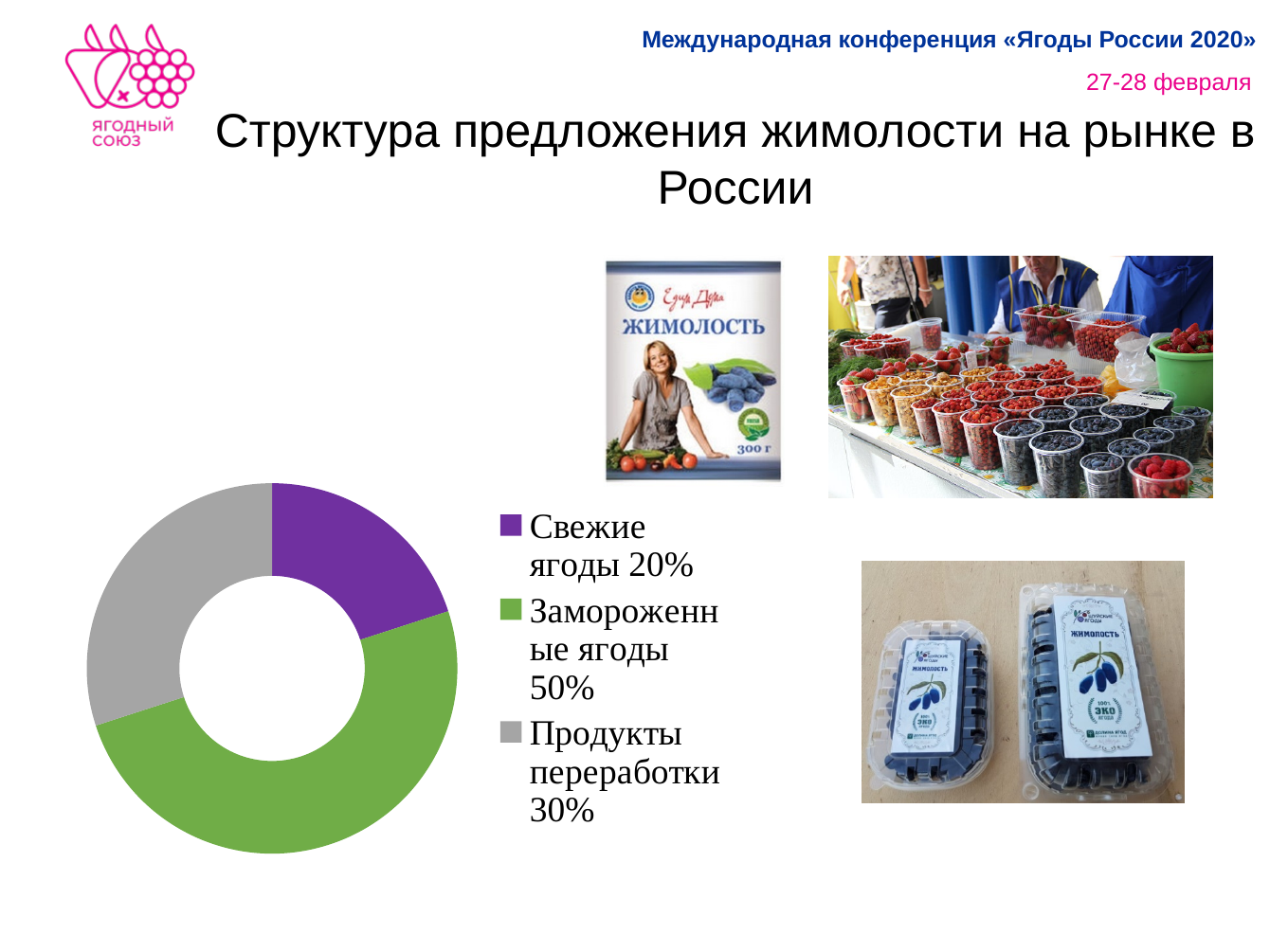
Which is larger: the share of processed products or the share of fresh berries? Продукты переработки What is the title of the slide containing the chart? Структура предложения жимолости на рынке в России What is the difference in percentage points between frozen berries and processed products? 20 What share of the honeysuckle supply is frozen berries (Замороженные ягоды)? 50% What is the difference in percentage points between frozen berries and fresh berries? 30 Which category has the smallest share in the chart? Свежие ягоды What share of the honeysuckle supply is processed products (Продукты переработки)? 30% What colour represents frozen berries (Замороженные ягоды) in the chart? Green What share of the honeysuckle supply is fresh berries (Свежие ягоды)? 20% How many categories does the chart show? 3 Which category has the largest share in the chart? Замороженные ягоды What kind of chart is shown on the slide? Doughnut (pie) chart